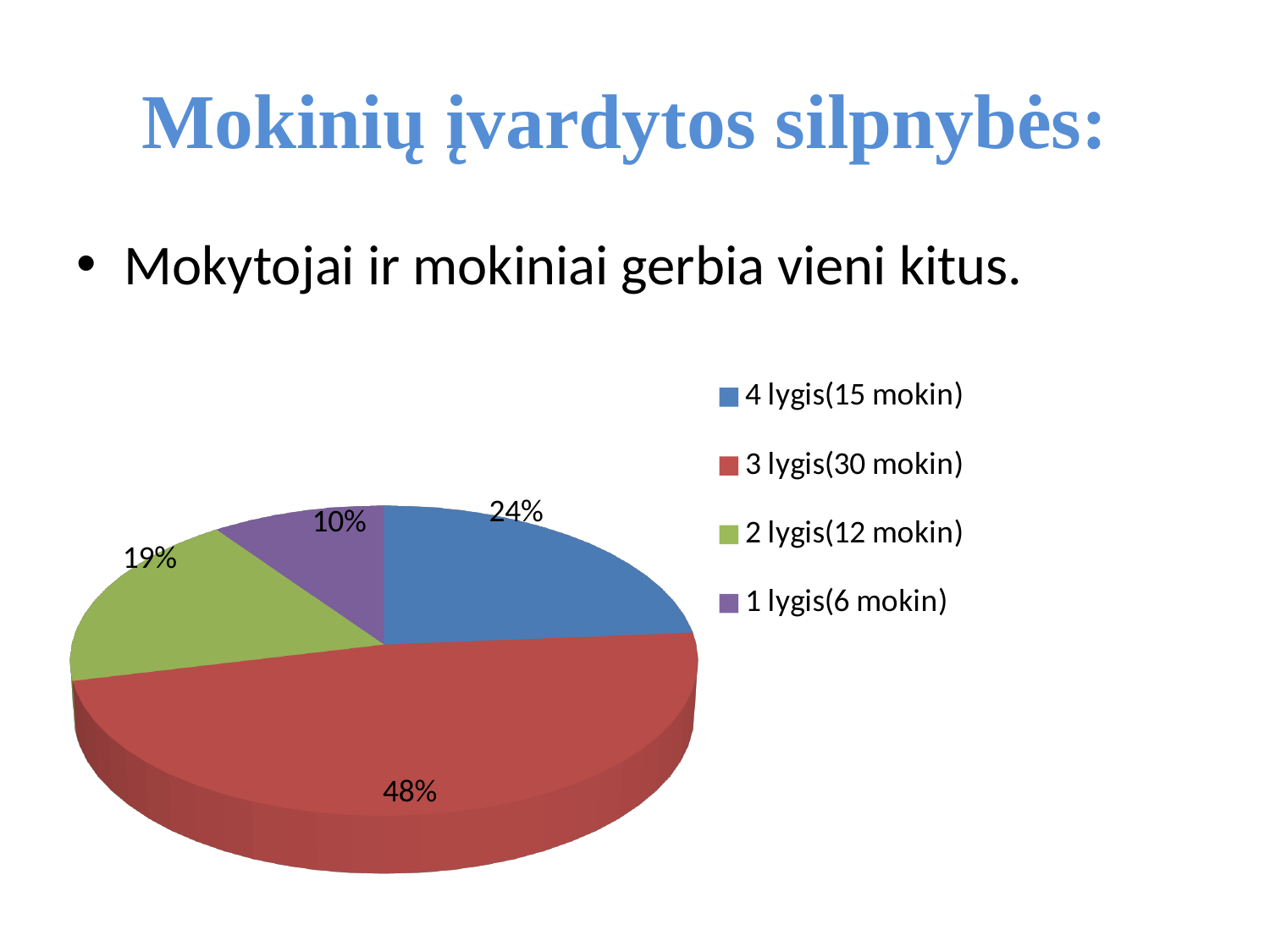
What is the difference in percentage points between the 3 lygis(30 mokin) slice and the 4 lygis(15 mokin) slice? 24% What percentage share does the slice for 4 lygis(15 mokin) have? 24% Which slice is larger, 2 lygis(12 mokin) or 1 lygis(6 mokin)? 2 lygis(12 mokin) What colour is the slice for 4 lygis(15 mokin)? blue How many entries does the legend list? 4 What percentage share does the slice for 2 lygis(12 mokin) have? 19% What kind of chart is shown on the slide? pie chart How many slices does the pie chart have? 4 What percentage share does the slice for 1 lygis(6 mokin) have? 10% Which category has the largest slice of the pie? 3 lygis(30 mokin) Which category has the smallest slice of the pie? 1 lygis(6 mokin)